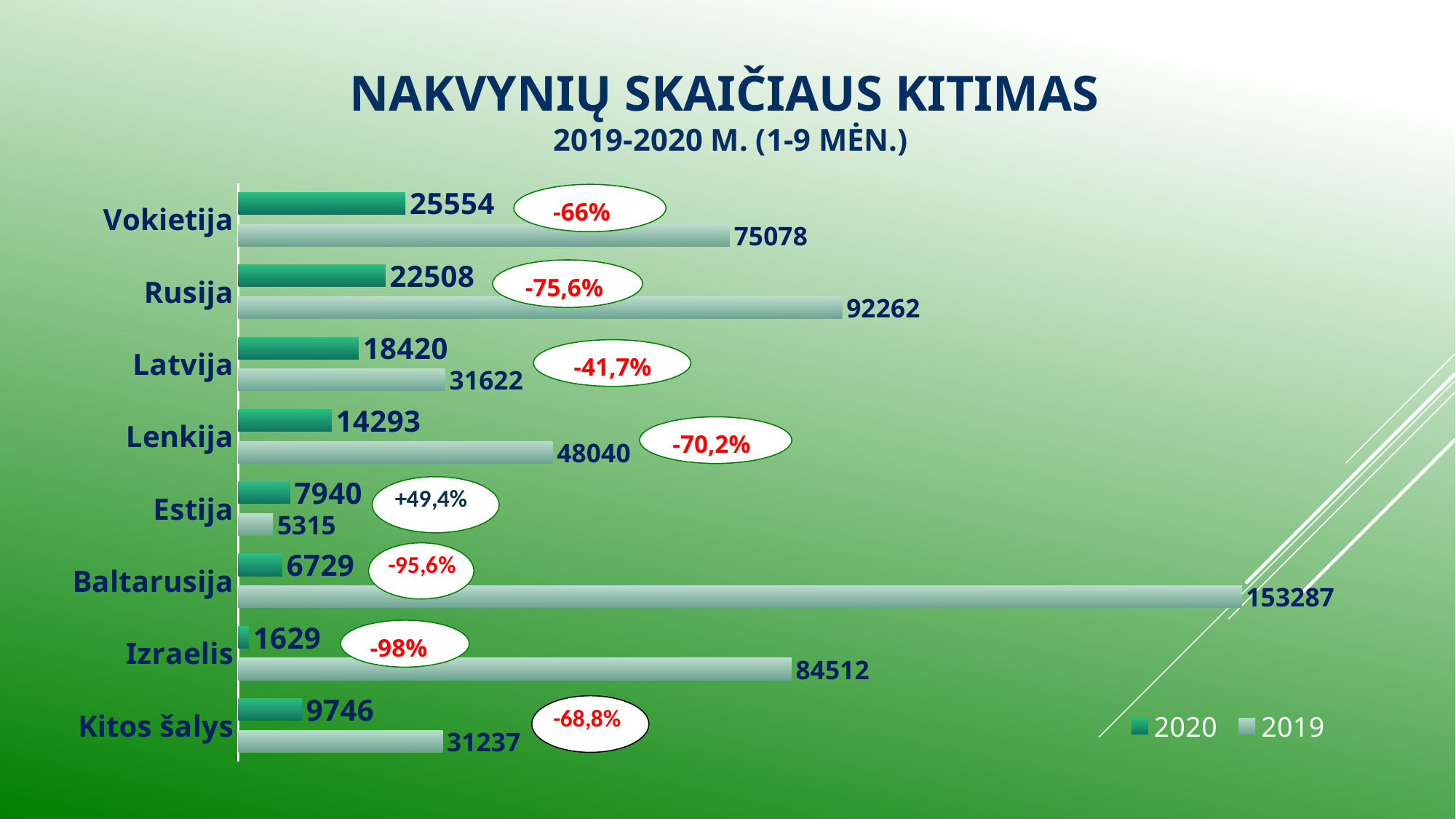
Which category has the lowest 2020 value? Izraelis What is the 2019 value for Latvija? 31622 How many countries/categories are shown on the chart? 8 What kind of chart is shown on the slide? bar chart What is the difference between the 2019 and 2020 values for Vokietija? 49524 What is the 2020 value for Lenkija? 14293 Which category has the highest 2020 value? Vokietija What percentage change is shown in the oval next to Estija? +49,4% Which category has the highest 2019 value? Baltarusija What is the difference between the 2019 and 2020 values for Baltarusija? 146558 How many series does the legend list? 2 Which is larger: the 2019 value for Rusija or the 2019 value for Izraelis? Rusija